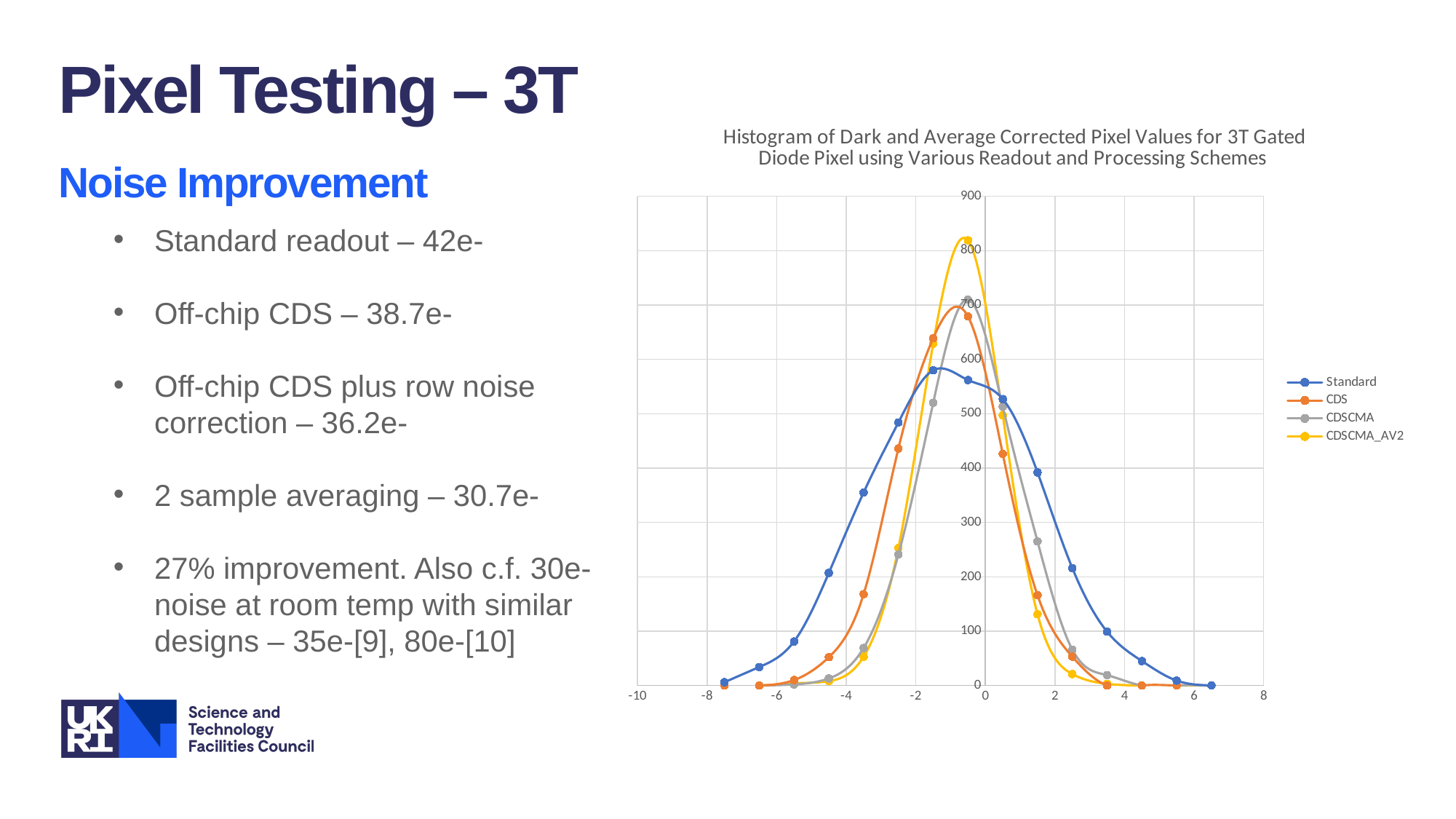
Is the value of the CDSCMA_AV2 series at x = 1.5 greater or less than 200? less Is the peak value of the Standard series greater or less than 600? less Which series reaches the highest peak value on the chart? CDSCMA_AV2 What colour is used for the Standard series in the chart? blue Which series has the lowest peak value on the chart? Standard Which series has a higher peak, Standard or CDSCMA_AV2? CDSCMA_AV2 Is the peak value of the CDSCMA_AV2 series greater or less than 700? greater What is the title of the chart? Histogram of Dark and Average Corrected Pixel Values for 3T Gated Diode Pixel using Various Readout and Processing Schemes How many series does the chart legend list? 4 What kind of chart is shown on the slide? line chart